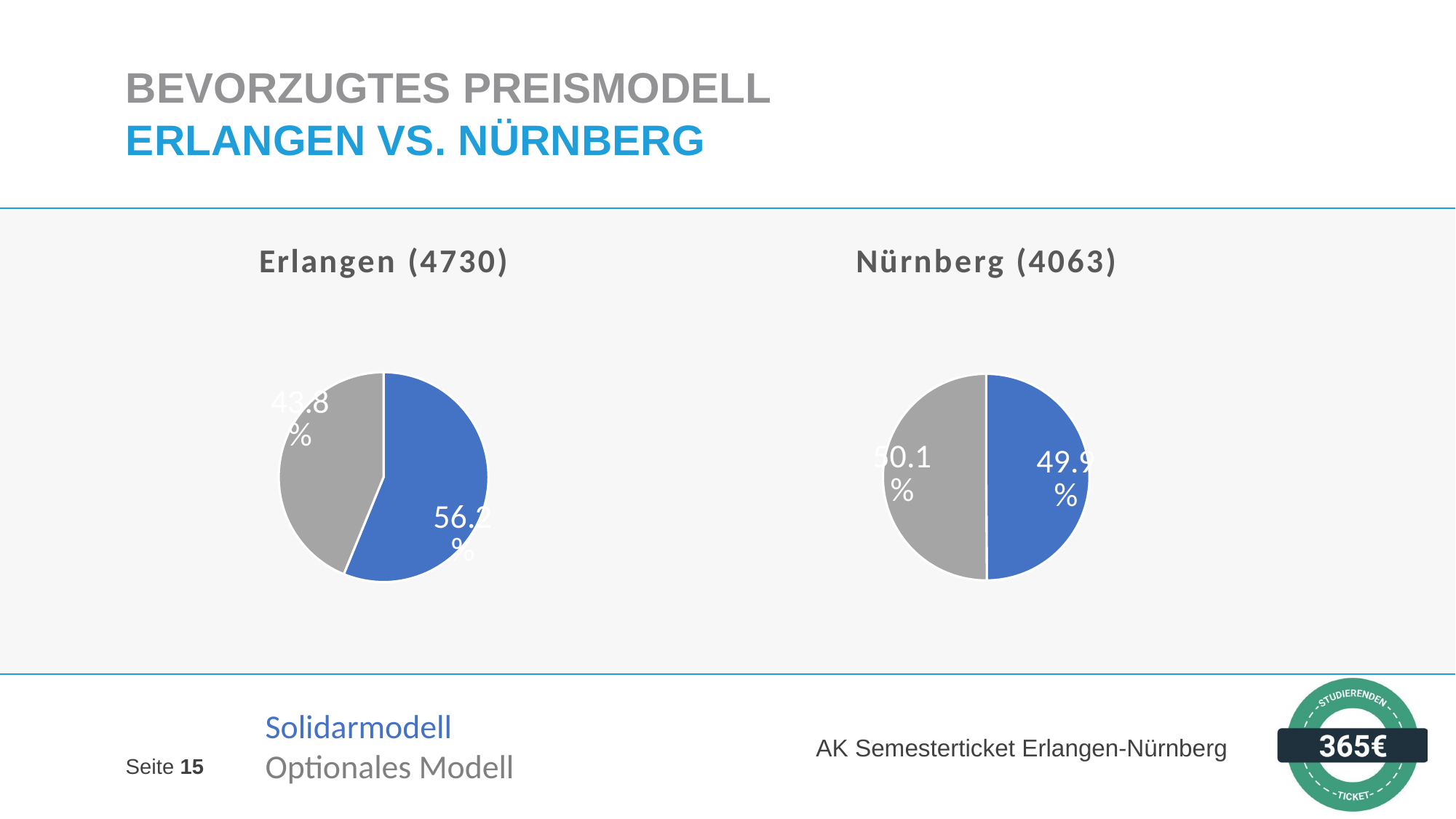
How many pie charts are on the slide? 2 In the Nürnberg (4063) chart, what share does the Optionales Modell slice have? 50.1% In the Erlangen (4730) chart, which model has the larger share? Solidarmodell In the Erlangen (4730) chart, what share does the Optionales Modell slice have? 43.8% What kind of charts are shown on the slide? Pie charts Is the Solidarmodell share in the Erlangen (4730) chart larger or smaller than in the Nürnberg (4063) chart? Larger Which colour represents the Solidarmodell in the pie charts? Blue In the Erlangen (4730) chart, what share does the Solidarmodell slice have? 56.2% In the Erlangen (4730) chart, what is the difference in percentage points between the Solidarmodell and Optionales Modell slices? 12.4 How many slices does each pie chart have? 2 What is the title of the pie chart on the right? Nürnberg (4063) In the Nürnberg (4063) chart, what share does the Solidarmodell slice have? 49.9%